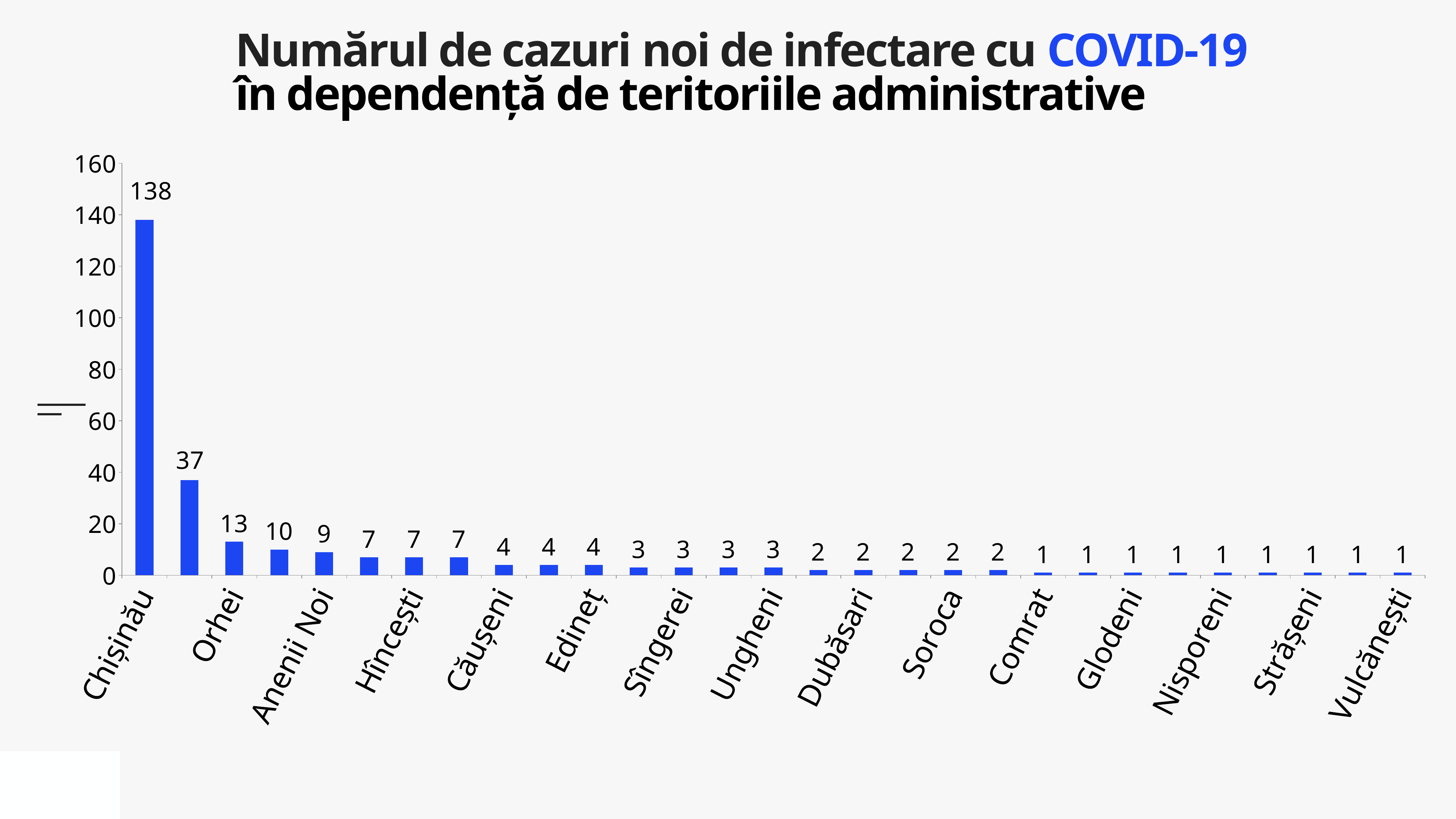
What kind of chart is shown on the slide? bar chart Which territory has the highest number of new COVID-19 cases? Chișinău What is the highest value shown on the vertical axis? 160 How many bars are plotted in the chart? 29 Do the values rise or fall from left to right along the x axis? fall Is the value for Chișinău greater or less than 120? greater How many bars have a data label of 1? 9 What is the difference between the highest bar (138) and the second highest bar (37)? 101 What colour are the bars in the chart? blue Which has more new cases, Chișinău or Orhei? Chișinău How many new cases are shown for Vulcănești, the last bar on the right? 1 How many new COVID-19 cases are shown for Chișinău? 138